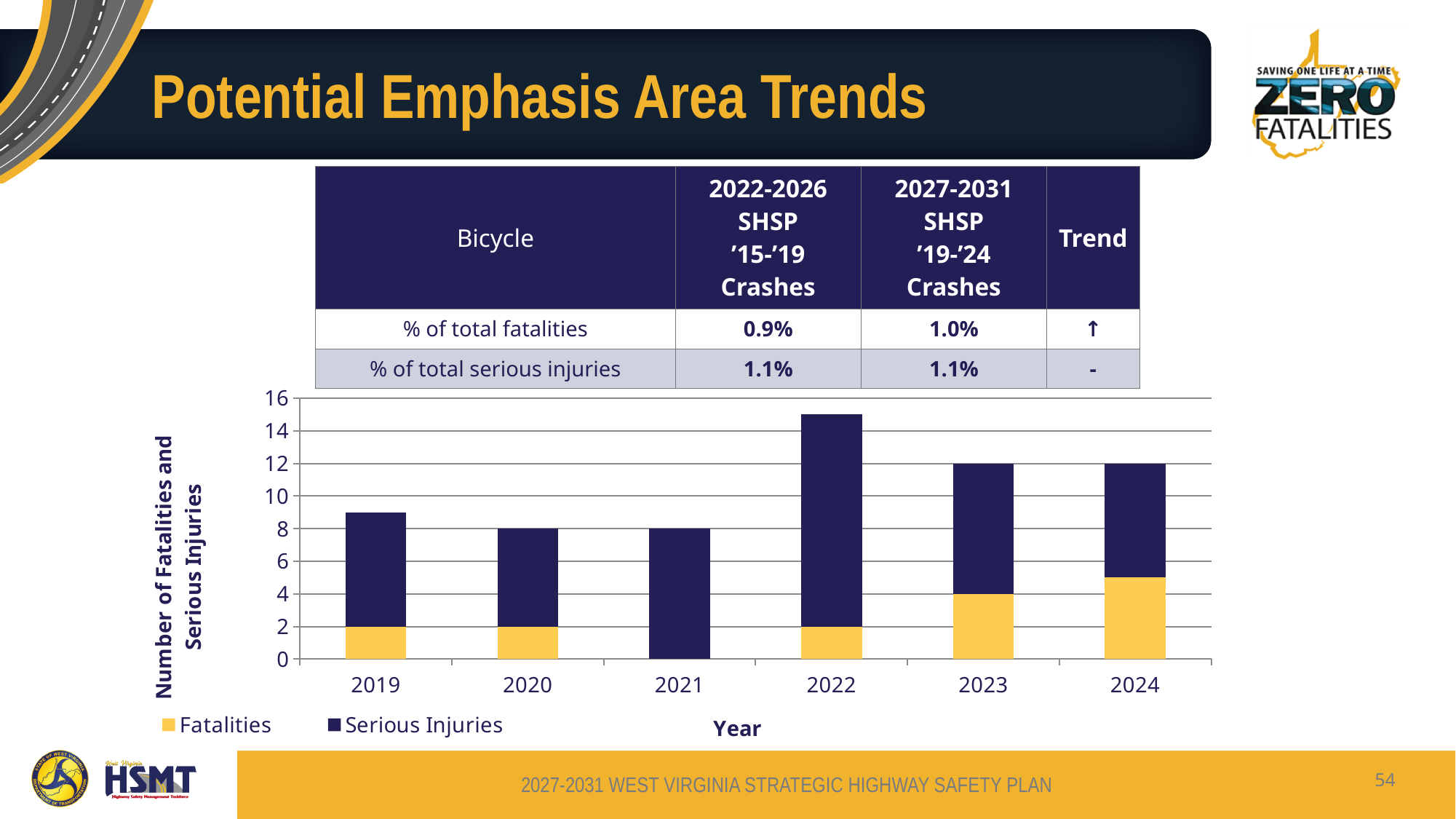
What is the title of the y axis of the chart? Number of Fatalities and Serious Injuries What kind of chart is shown on the slide? Stacked bar chart What is the total number of fatalities and serious injuries in 2020? 8 Is the total for 2022 greater or less than 14? greater Which year has a larger total, 2019 or 2023? 2023 How many series does the chart legend list? 2 Which year has the lowest number of fatalities? 2021 How many fatalities are shown for 2023? 4 What is the total number of fatalities and serious injuries in 2023? 12 Which year has the highest total of fatalities and serious injuries? 2022 How many years are shown on the x axis of the chart? 6 How many serious injuries are shown for 2021? 8